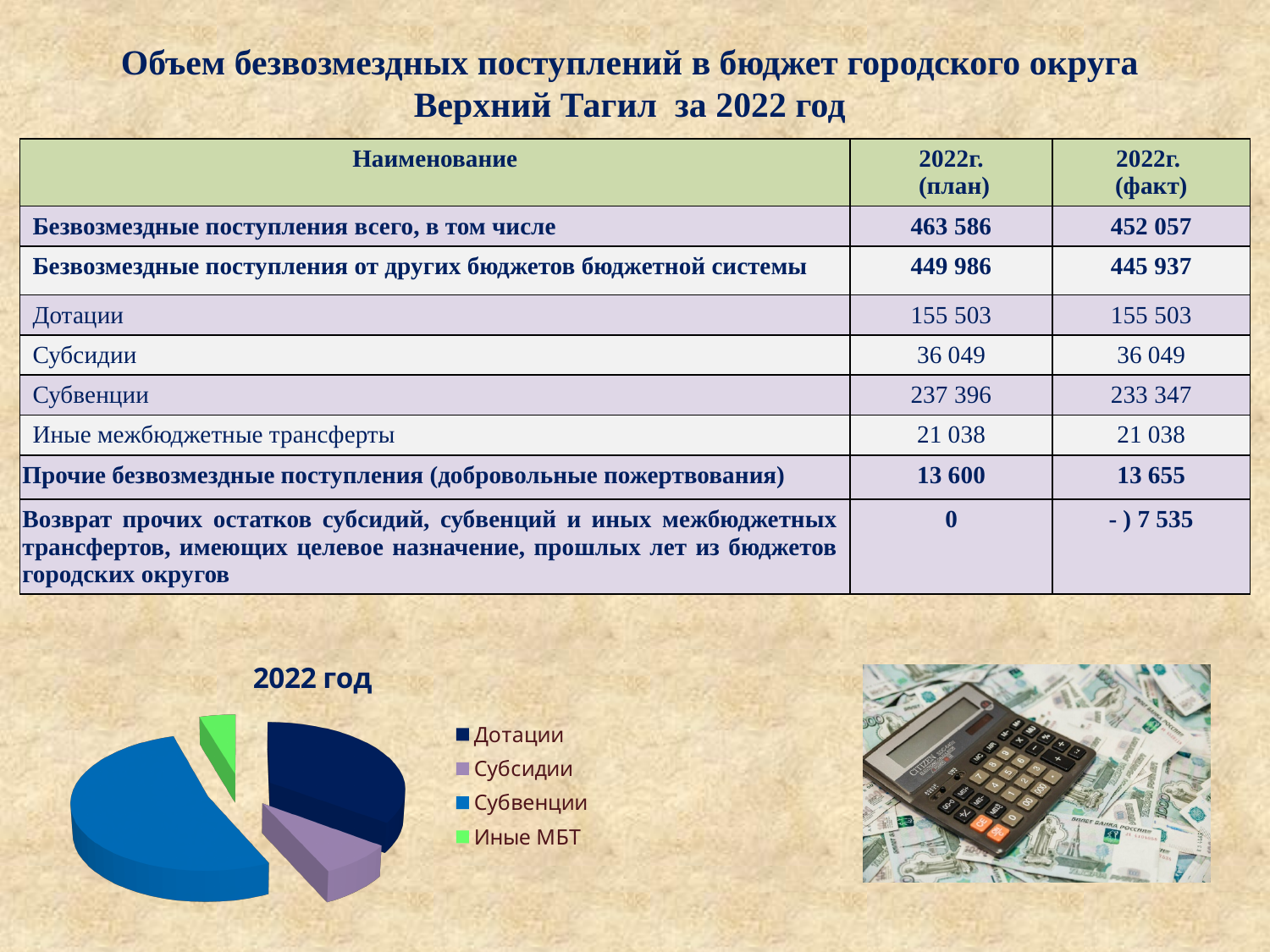
In the pie chart, which slice is larger: Субвенции or Дотации? Субвенции How many slices does the pie chart have? 4 Which category has the smallest slice in the pie chart? Иные МБТ What is the title of the pie chart? 2022 год How many entries does the legend of the pie chart list? 4 In the pie chart, which slice is larger: Субсидии or Иные МБТ? Субсидии Which category has the largest slice in the pie chart? Субвенции In the pie chart, which slice is larger: Дотации or Субсидии? Дотации What colour represents Субвенции in the pie chart? blue What kind of chart is shown on the slide? pie chart